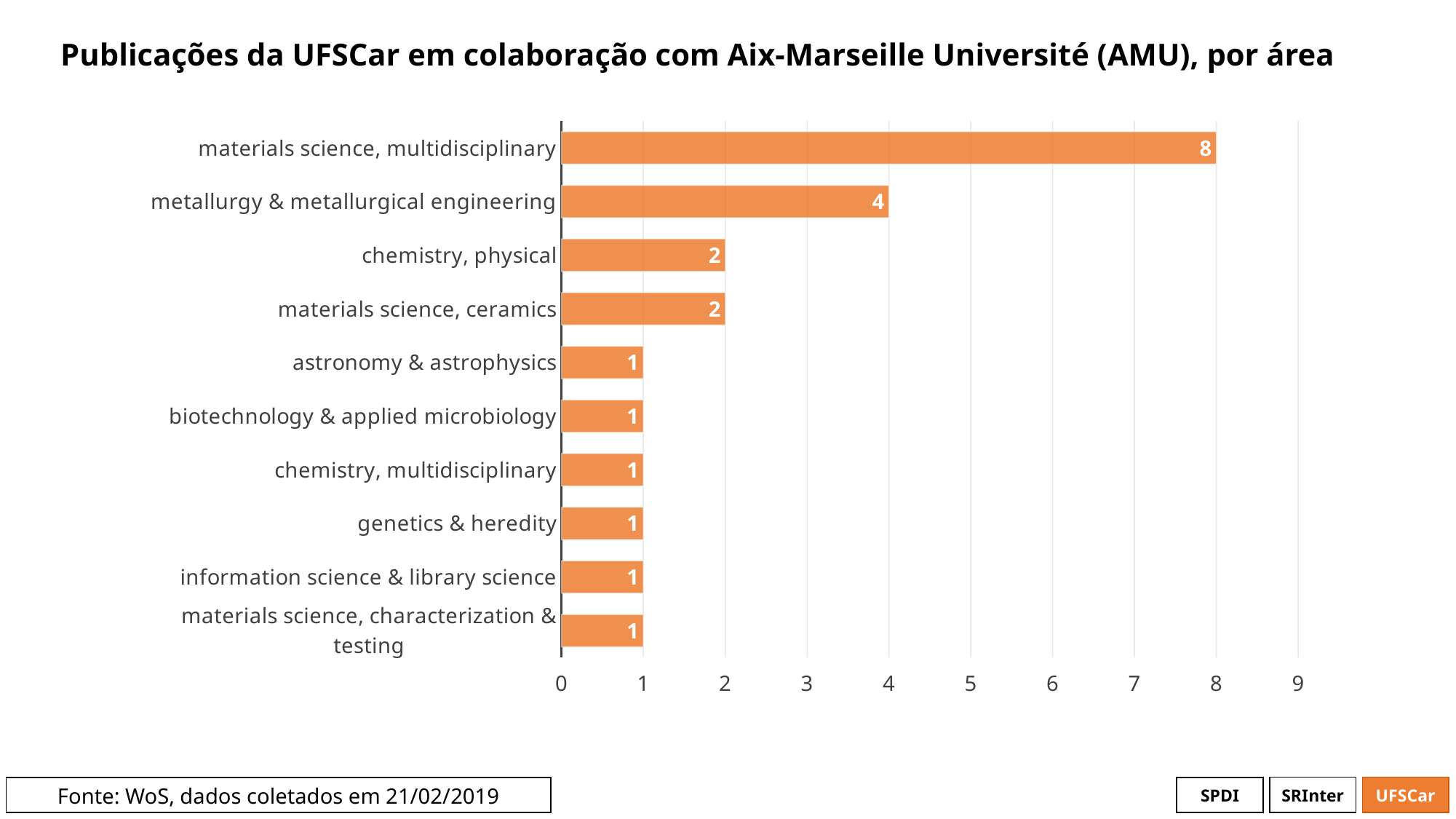
What is the value for materials science, multidisciplinary? 8 Is the value for materials science, multidisciplinary greater or less than 5? greater What is the value for chemistry, physical? 2 What is the difference between materials science, multidisciplinary and metallurgy & metallurgical engineering? 4 Which area has the highest number of publications? materials science, multidisciplinary Which is larger, chemistry, physical or astronomy & astrophysics? chemistry, physical What is the value for genetics & heredity? 1 What kind of chart is shown on the slide? bar chart How many areas are shown in the chart? 10 What is the value for metallurgy & metallurgical engineering? 4 What is the difference between metallurgy & metallurgical engineering and materials science, ceramics? 2 What is the title of the chart? Publicações da UFSCar em colaboração com Aix-Marseille Université (AMU), por área